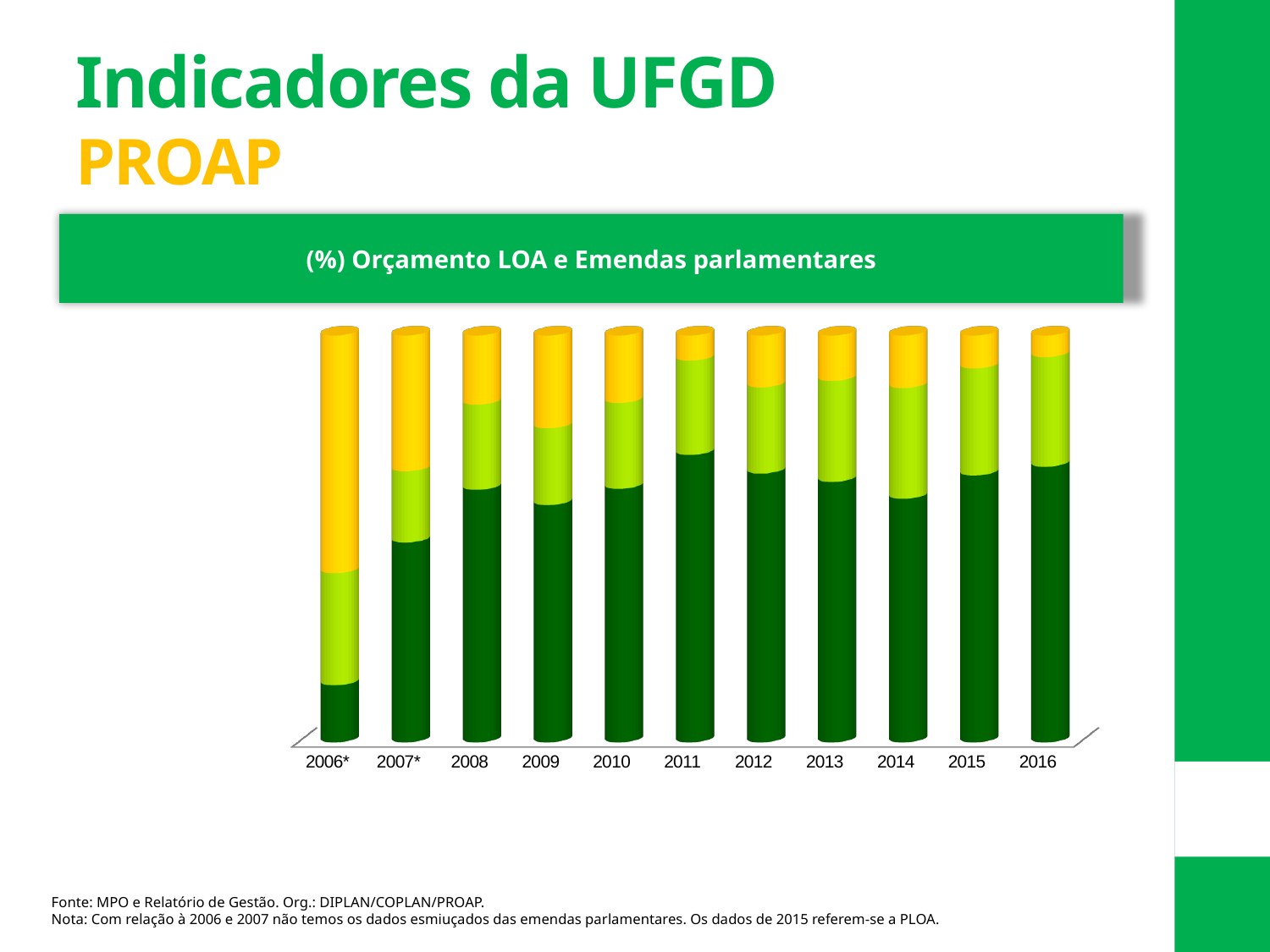
Which year has the largest yellow segment? 2006* Which year has the largest dark green segment? 2011 Which is the last year shown on the x axis? 2016 Is the yellow segment larger in 2007* or in 2016? 2007* Is the dark green segment larger in 2006* or in 2011? 2011 How many differently coloured segments make up each stacked bar? 3 How many years (categories) are shown on the x axis of the chart? 11 What kind of chart is shown on the slide? Stacked bar chart Which is the first year shown on the x axis? 2006* Which year has the smallest dark green segment? 2006* Is the light green segment larger in 2006* or in 2008? 2006*